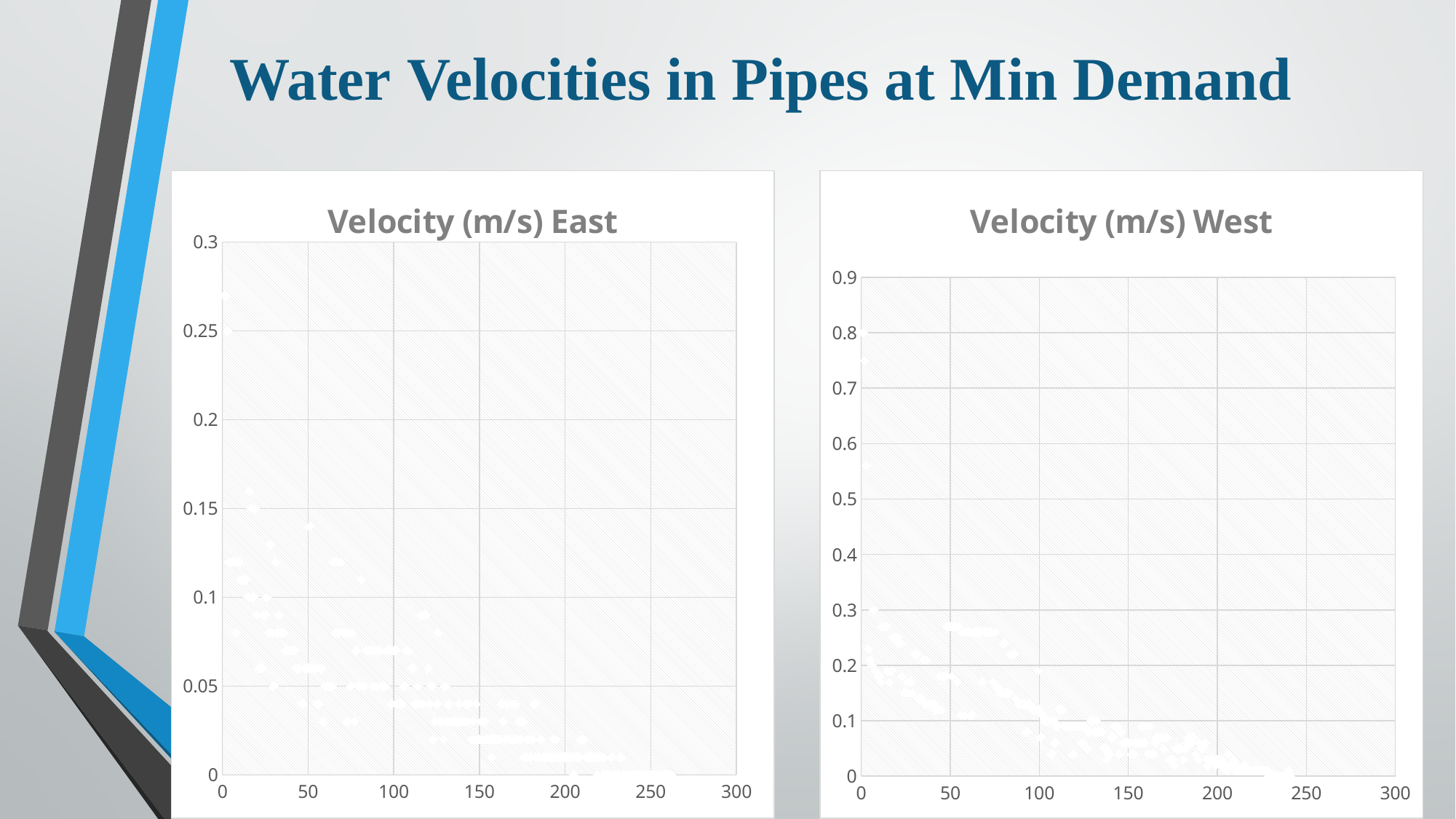
In the "Velocity (m/s) East" chart, what is the highest value shown on the y-axis? 0.3 In the "Velocity (m/s) West" chart, what is the highest value shown on the y-axis? 0.9 What is the title of the chart on the left of the slide? Velocity (m/s) East What is the title of the chart on the right of the slide? Velocity (m/s) West How many charts are shown on the slide? 2 In the "Velocity (m/s) West" chart, do the plotted values generally rise or fall as the x-axis value increases? fall What kind of chart is the "Velocity (m/s) East" chart? scatter chart In the "Velocity (m/s) East" chart, do the plotted values generally rise or fall as the x-axis value increases? fall Which chart has the larger maximum y-axis value, "Velocity (m/s) East" or "Velocity (m/s) West"? Velocity (m/s) West What kind of chart is the "Velocity (m/s) West" chart? scatter chart In the "Velocity (m/s) East" chart, what is the highest value shown on the x-axis? 300